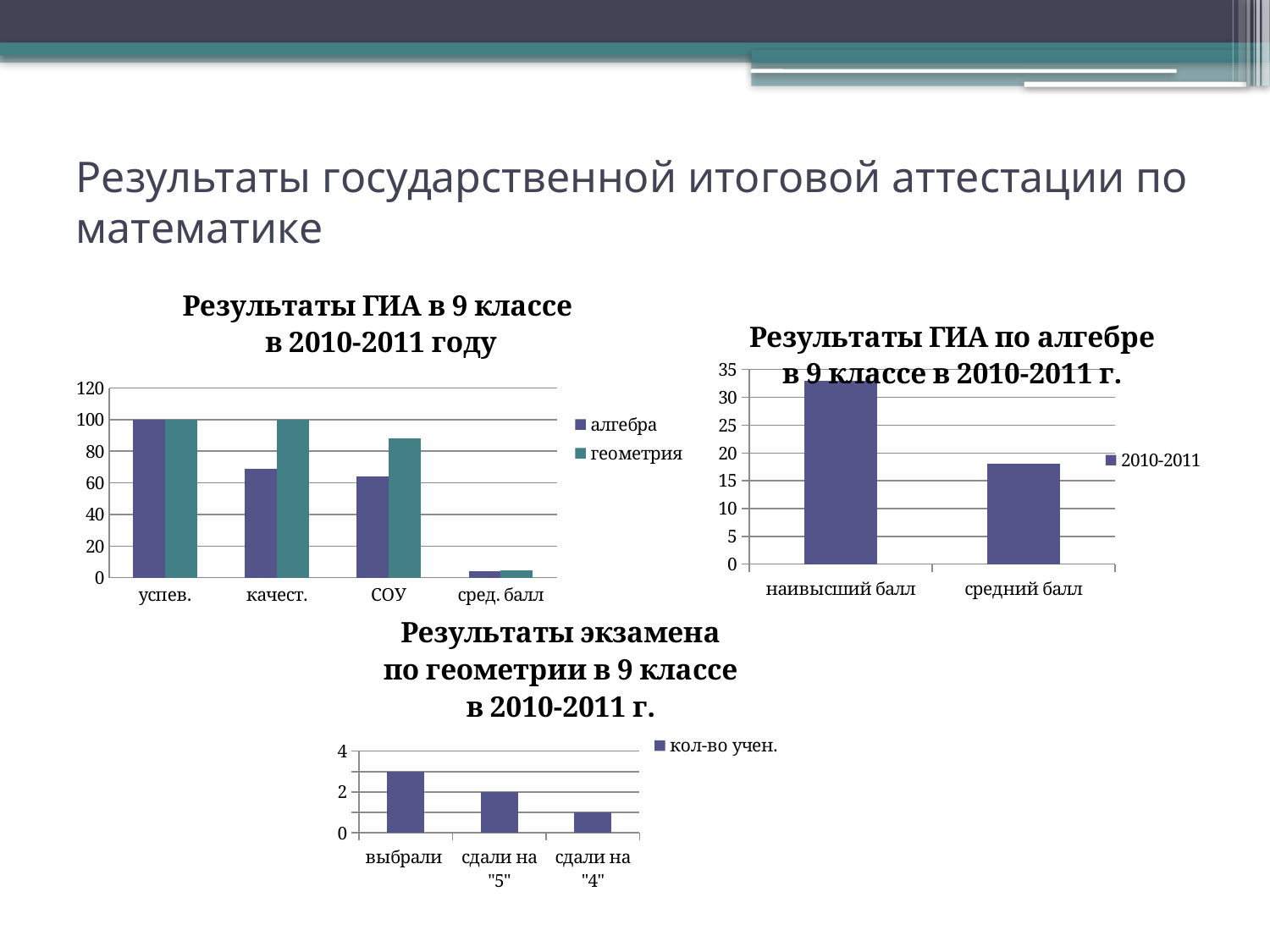
How many series does the legend of the chart 'Результаты ГИА в 9 классе в 2010-2011 году' list? 2 In the chart 'Результаты ГИА в 9 классе в 2010-2011 году', is the value for алгебра in the category качест. greater or less than 80? less In the chart 'Результаты ГИА в 9 классе в 2010-2011 году', which category has the lowest values? сред. балл In the chart 'Результаты ГИА в 9 классе в 2010-2011 году', what is the value for геометрия in the category качест.? 100 In the chart 'Результаты ГИА в 9 классе в 2010-2011 году', what is the value for алгебра in the category успев.? 100 In the chart 'Результаты ГИА по алгебре в 9 классе в 2010-2011 г.', is the value for наивысший балл greater or less than 30? greater In the chart 'Результаты экзамена по геометрии в 9 классе в 2010-2011 г.', what is the value for сдали на "5"? 2 In the chart 'Результаты ГИА по алгебре в 9 классе в 2010-2011 г.', is the value for средний балл greater or less than 20? less How many categories are shown on the x axis of the chart 'Результаты ГИА в 9 классе в 2010-2011 году'? 4 What kind of chart is 'Результаты экзамена по геометрии в 9 классе в 2010-2011 г.'? bar chart In the chart 'Результаты ГИА в 9 классе в 2010-2011 году', which series has the larger value in the category СОУ, алгебра or геометрия? геометрия In the chart 'Результаты экзамена по геометрии в 9 классе в 2010-2011 г.', which category has the highest value? выбрали